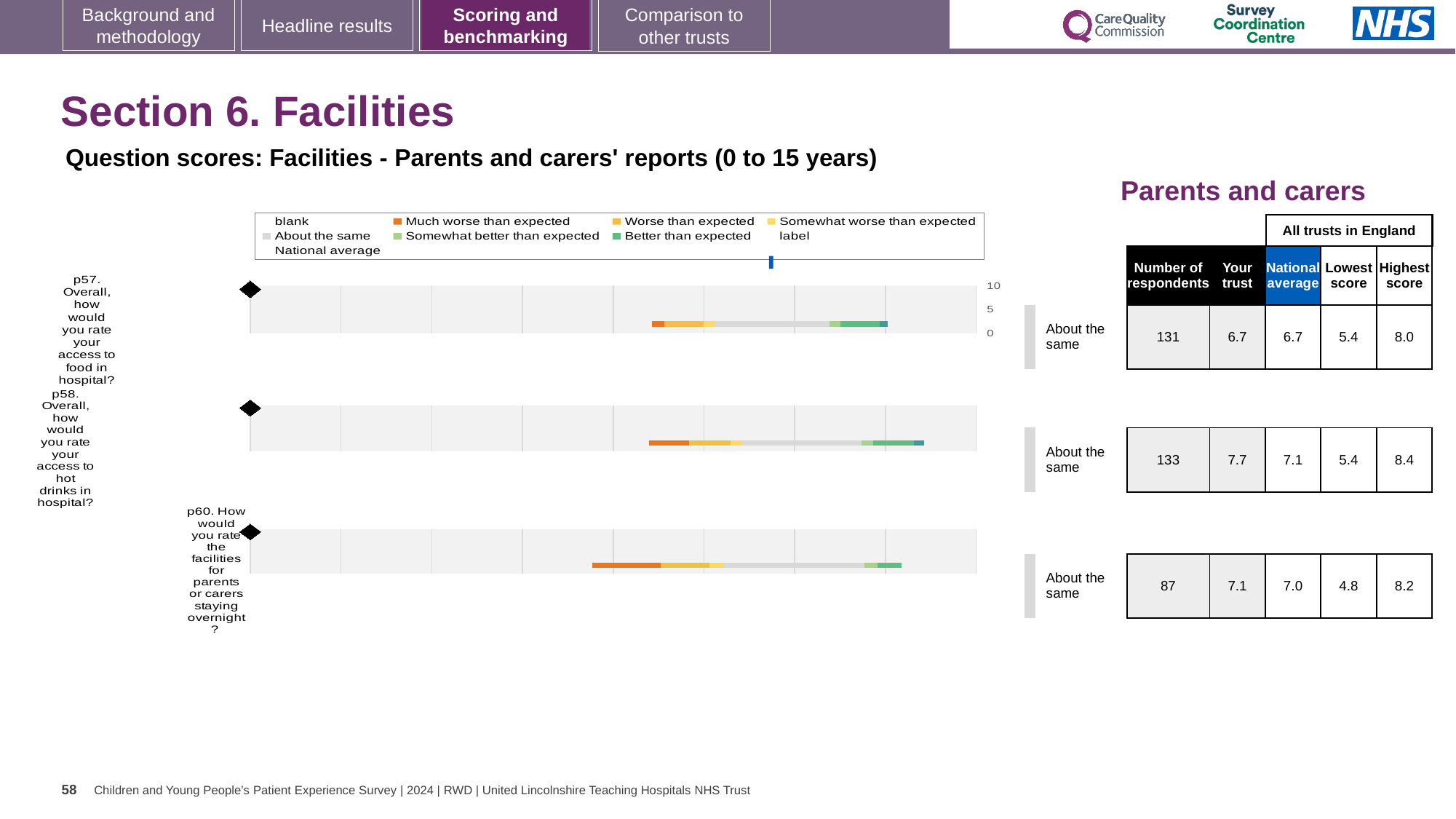
Which question has the highest 'Highest score' across all trusts in England? p58 How many entries does the chart legend list? 9 What is the maximum value shown on the chart's score axis? 10 Which question has the fewest respondents? p60 What is the 'Your trust' score for p57 (access to food in hospital)? 6.7 For p58, which is larger: the 'Your trust' score or the national average? Your trust How many questions (categories) are plotted in the Facilities chart? 3 What is the difference between the 'Your trust' score and the national average for p58? 0.6 What kind of chart is used to show the question scores on this slide? bar chart How many respondents answered p60? 87 What is the national average score for p60 (facilities for parents or carers staying overnight)? 7.0 What is the 'Your trust' score for p58 (access to hot drinks in hospital)? 7.7